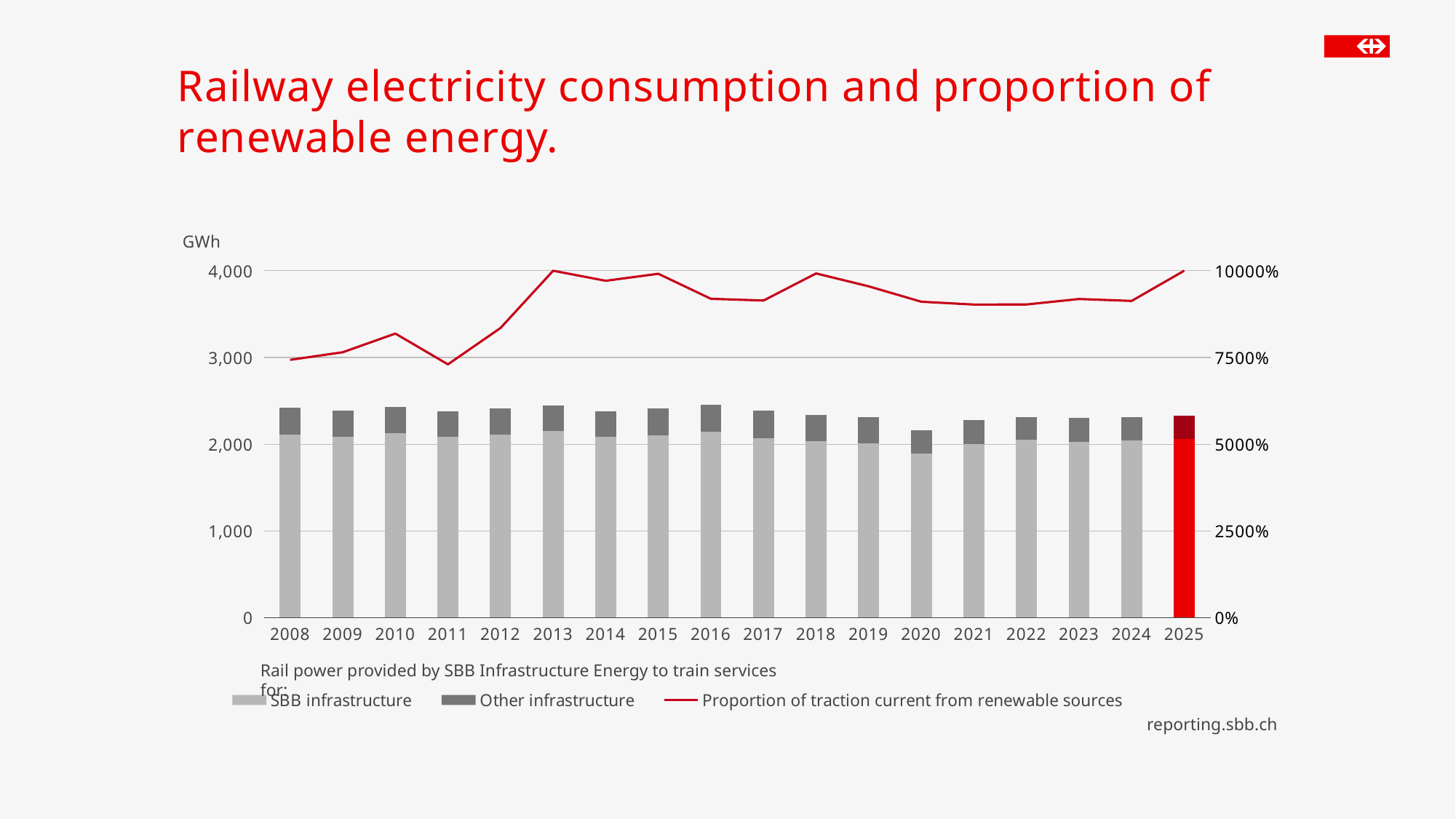
Is the proportion of traction current from renewable sources in 2020 greater or less than 7500%? greater Is the proportion of traction current from renewable sources in 2013 greater or less than 7500%? greater What kind of chart is shown on the slide? Stacked bar chart with a line How many series does the chart legend list? 3 Which year has the lowest total bar (SBB infrastructure plus Other infrastructure)? 2020 Which year has the higher proportion of traction current from renewable sources, 2011 or 2013? 2013 Which year has the larger total bar, 2008 or 2020? 2008 Does the proportion of traction current from renewable sources rise or fall overall from 2008 to 2013? rise Is the total bar for 2016 greater or less than 2,000 GWh? greater What unit is shown on the left axis of the chart? GWh How many years are shown on the x axis of the chart? 18 What colour is the bar for 2025? Red